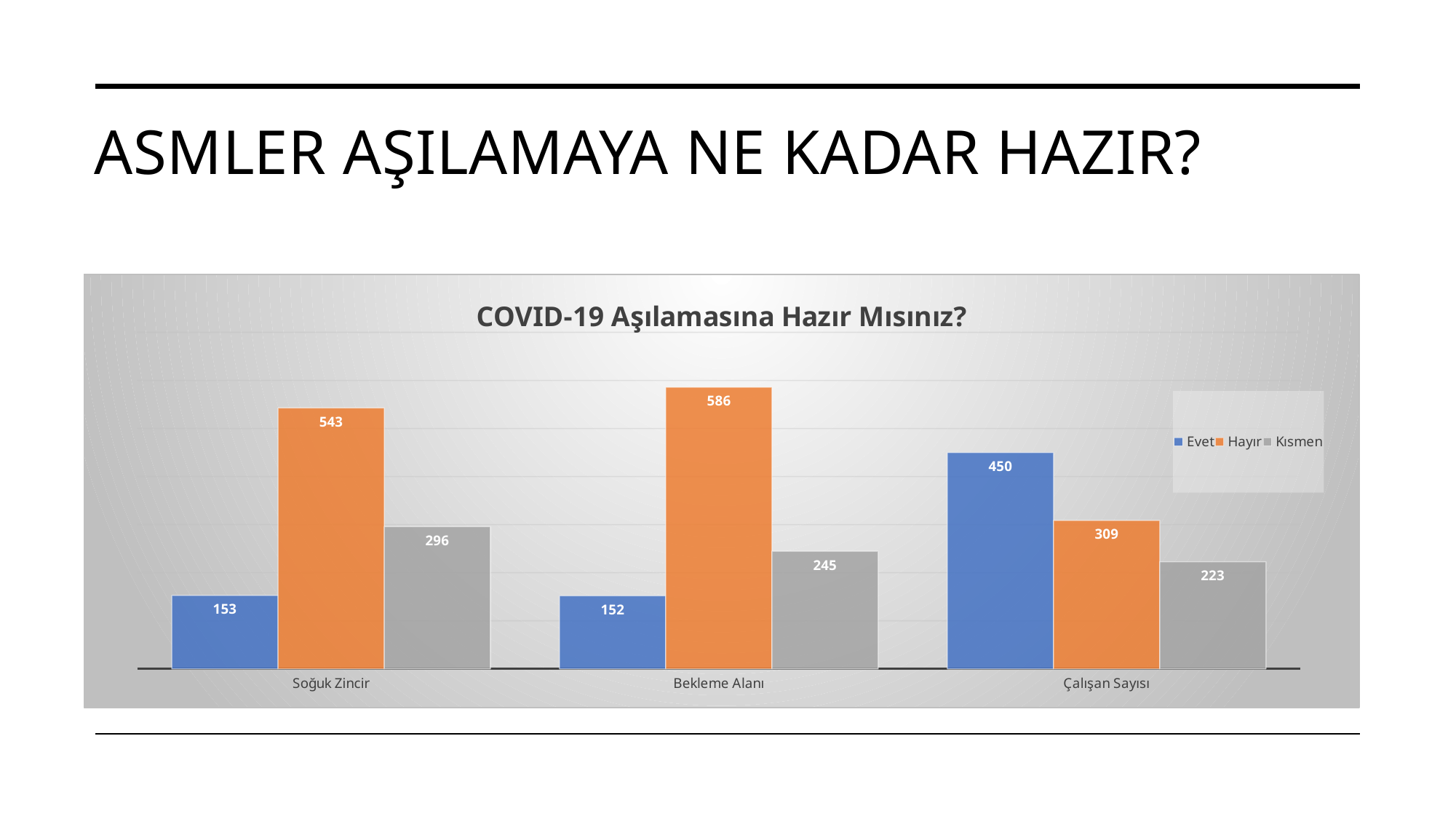
What kind of chart is shown on the slide? Bar chart How many series does the legend list? 3 What is the difference between the Hayır and Evet values for Soğuk Zincir? 390 Which is larger for Çalışan Sayısı: Evet or Hayır? Evet What is the value for Kısmen in the Soğuk Zincir category? 296 Which category has the lowest Kısmen value? Çalışan Sayısı How many categories are shown on the x axis? 3 What is the value for Hayır in the Bekleme Alanı category? 586 Which colour represents the Hayır series? Orange What is the title of the chart? COVID-19 Aşılamasına Hazır Mısınız? Which category has the highest Hayır value? Bekleme Alanı What is the value for Evet in the Çalışan Sayısı category? 450